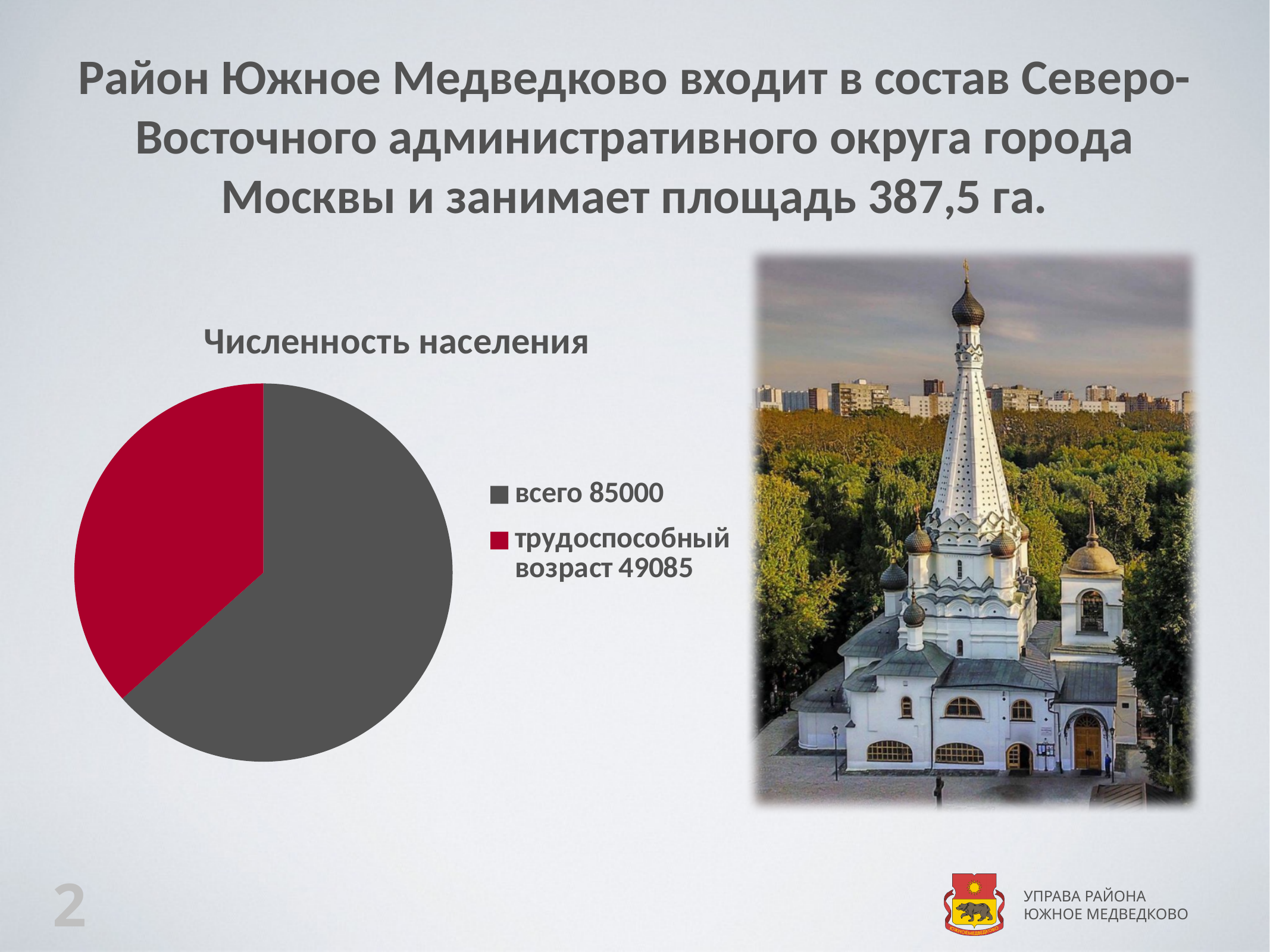
What value is given for "всего" in the chart legend? 85000 Which is larger, the value for "всего" or the value for "трудоспособный возраст"? всего What colour is the slice for "трудоспособный возраст" in the pie chart? red Which slice of the pie chart is the smallest? трудоспособный возраст 49085 What value is given for "трудоспособный возраст" in the chart legend? 49085 Which slice of the pie chart is the largest? всего 85000 What is the title of the chart? Численность населения What kind of chart is shown on the slide? pie chart What is the difference between the value for "всего" and the value for "трудоспособный возраст"? 35915 How many entries does the chart legend list? 2 How many slices does the pie chart have? 2